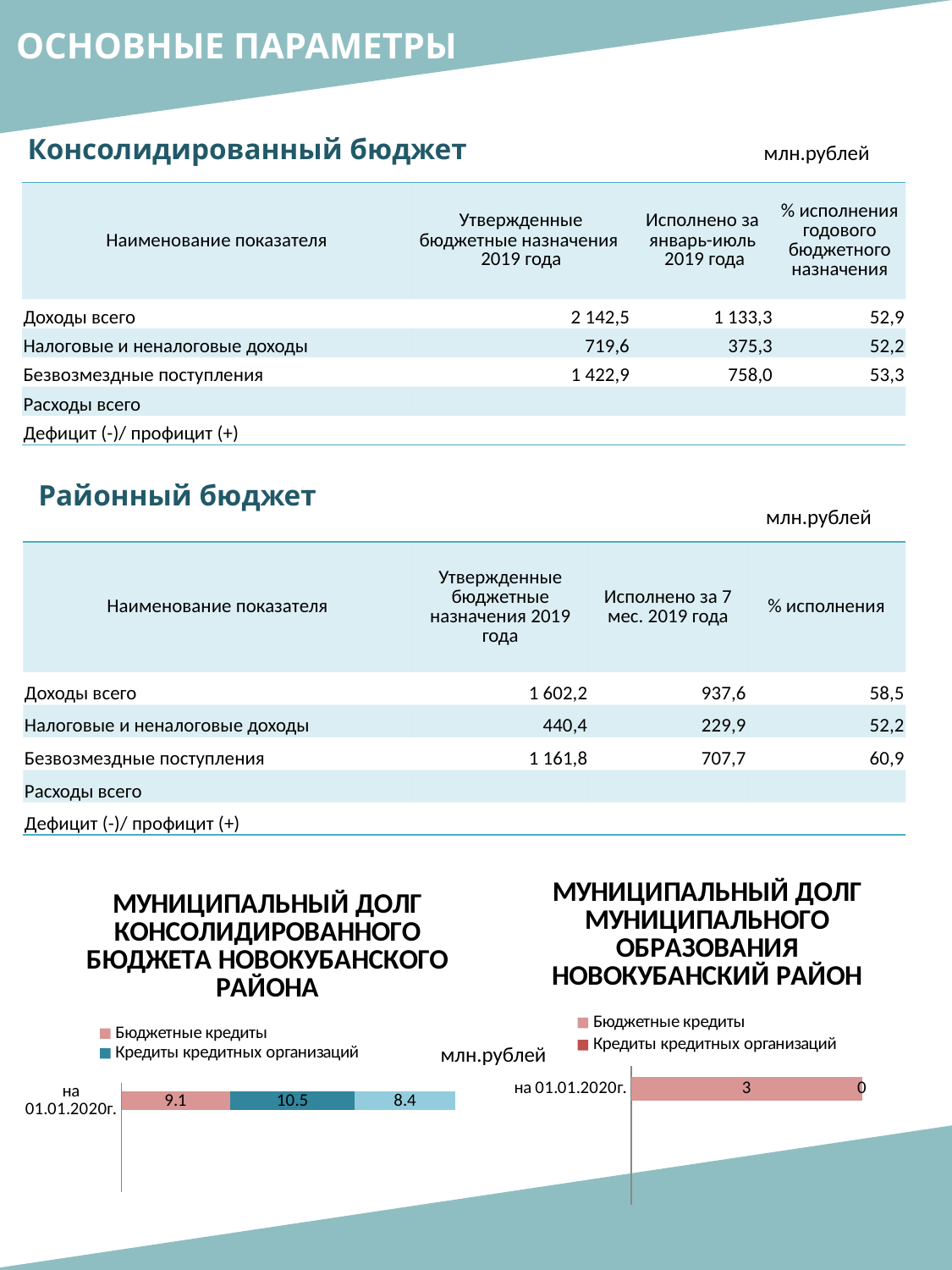
In the right chart (municipal debt of the municipal formation), how many series does the legend list? 2 In the chart titled 'МУНИЦИПАЛЬНЫЙ ДОЛГ МУНИЦИПАЛЬНОГО ОБРАЗОВАНИЯ НОВОКУБАНСКИЙ РАЙОН', what is the value for 'Кредиты кредитных организаций'? 0 What kind of chart is the left chart (consolidated budget municipal debt)? Bar chart In the left chart (consolidated budget municipal debt), which is larger: 'Бюджетные кредиты' or 'Кредиты кредитных организаций'? Кредиты кредитных организаций How many categories (dates) are shown on the axis of the right chart (municipal debt of the municipal formation)? 1 In the chart titled 'МУНИЦИПАЛЬНЫЙ ДОЛГ МУНИЦИПАЛЬНОГО ОБРАЗОВАНИЯ НОВОКУБАНСКИЙ РАЙОН', what is the value for 'Бюджетные кредиты'? 3 In the left chart (consolidated budget municipal debt), what is the value of the third, light-blue segment of the bar? 8.4 In the chart titled 'МУНИЦИПАЛЬНЫЙ ДОЛГ КОНСОЛИДИРОВАННОГО БЮДЖЕТА НОВОКУБАНСКОГО РАЙОНА', what is the value for 'Кредиты кредитных организаций'? 10.5 In the left chart (consolidated budget municipal debt), what is the total of the stacked bar for 01.01.2020? 28 In the right chart (municipal debt of the municipal formation), which series has the higher value: 'Бюджетные кредиты' or 'Кредиты кредитных организаций'? Бюджетные кредиты In the left chart (consolidated budget municipal debt), what is the difference between 'Кредиты кредитных организаций' and 'Бюджетные кредиты'? 1.4 In the chart titled 'МУНИЦИПАЛЬНЫЙ ДОЛГ КОНСОЛИДИРОВАННОГО БЮДЖЕТА НОВОКУБАНСКОГО РАЙОНА', what is the value for 'Бюджетные кредиты' on 01.01.2020? 9.1